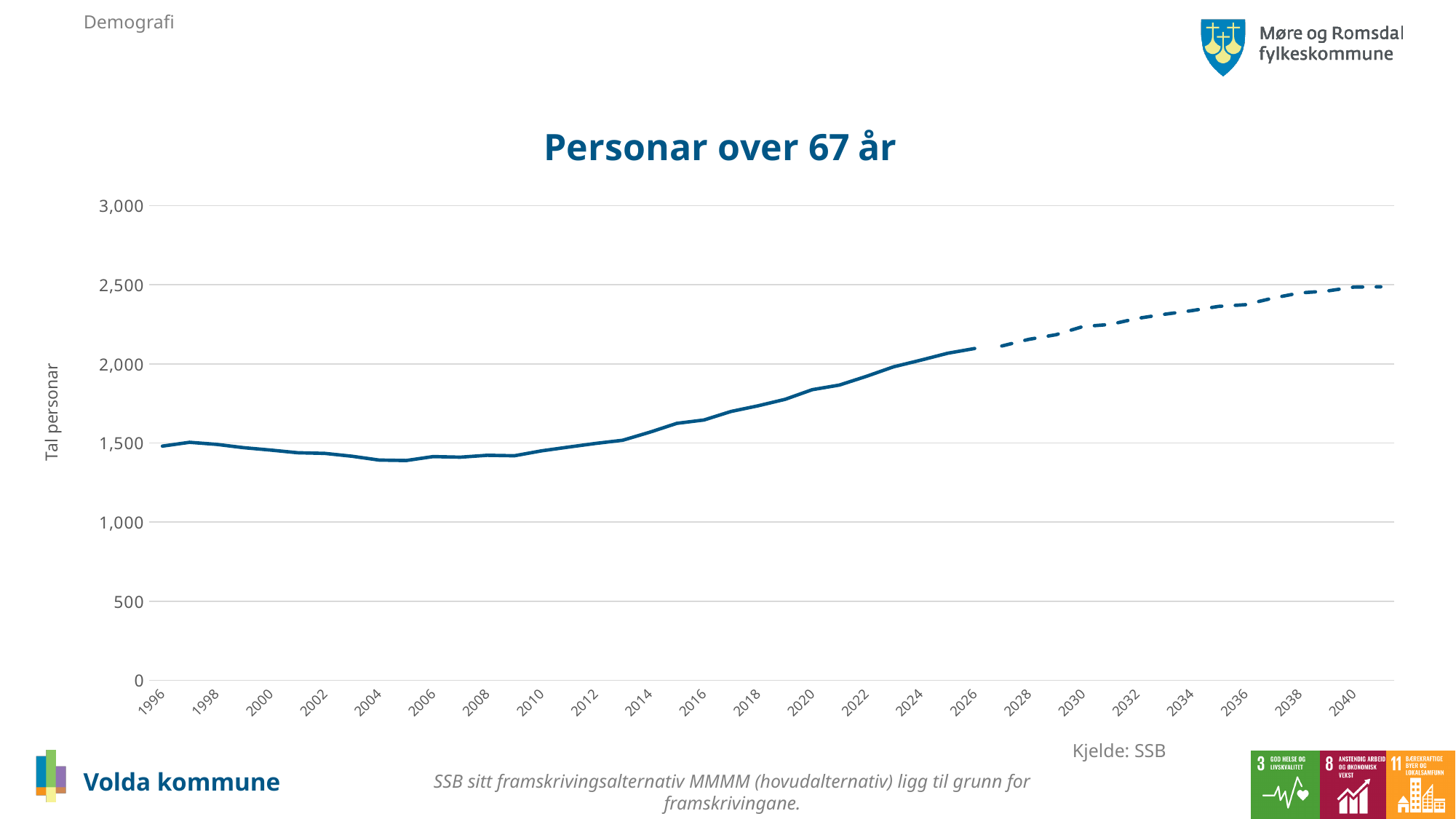
Is the value for 2004 greater or less than 1,500? less Is the value for 2020 greater or less than 2,000? less How many year labels are shown on the horizontal axis? 23 Is the value for 2010 greater or less than 1,500? less Which year has the larger value, 2010 or 2020? 2020 What is the title of the chart? Personar over 67 år Which year has the larger value, 2000 or 2030? 2030 What kind of chart is shown on the slide? Line chart What is the label on the vertical axis of the chart? Tal personar Does the line rise or fall between 2005 and 2026? Rises